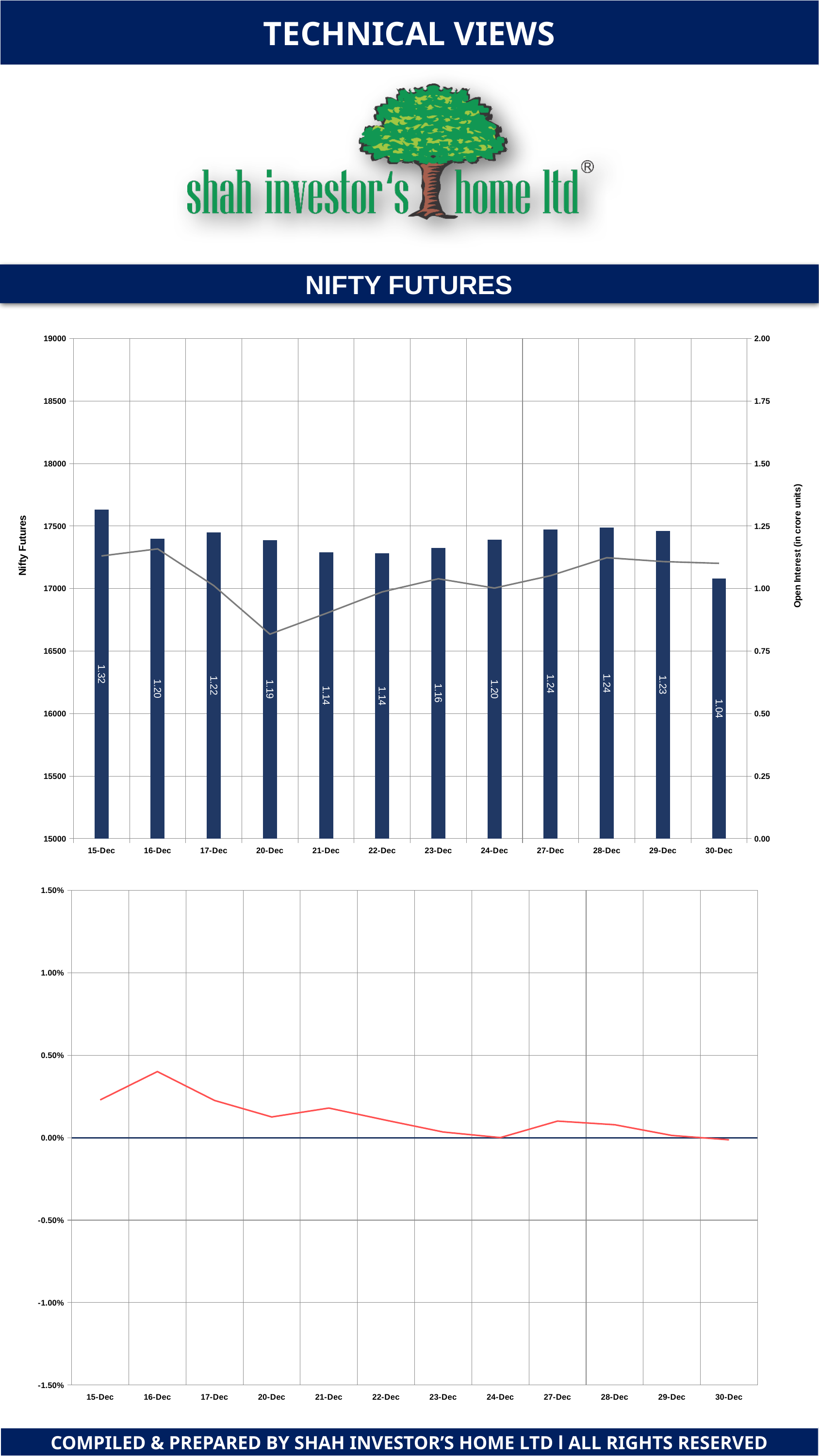
In the bottom chart, does the red line generally rise or fall from 16-Dec to 30-Dec? fall In the bottom chart, is the red line value for 16-Dec greater or less than 0.50%? less In the top NIFTY FUTURES chart, how many dates are shown on the x axis? 12 In the top NIFTY FUTURES chart, what value is labelled on the bar for 27-Dec? 1.24 In the top NIFTY FUTURES chart, which bar is taller: 17-Dec or 21-Dec? 17-Dec In the top NIFTY FUTURES chart, which date has the lowest labelled bar value? 30-Dec What is the label on the right-hand vertical axis of the top NIFTY FUTURES chart? Open Interest (in crore units) In the top NIFTY FUTURES chart, what is the open interest value labelled on the bar for 15-Dec? 1.32 In the top NIFTY FUTURES chart, what is the difference between the bar values for 15-Dec and 30-Dec? 0.28 In the top NIFTY FUTURES chart, is the grey line value for 20-Dec greater or less than 17000? less In the top NIFTY FUTURES chart, what is the open interest value labelled on the bar for 30-Dec? 1.04 In the top NIFTY FUTURES chart, which date has the highest labelled bar value? 15-Dec